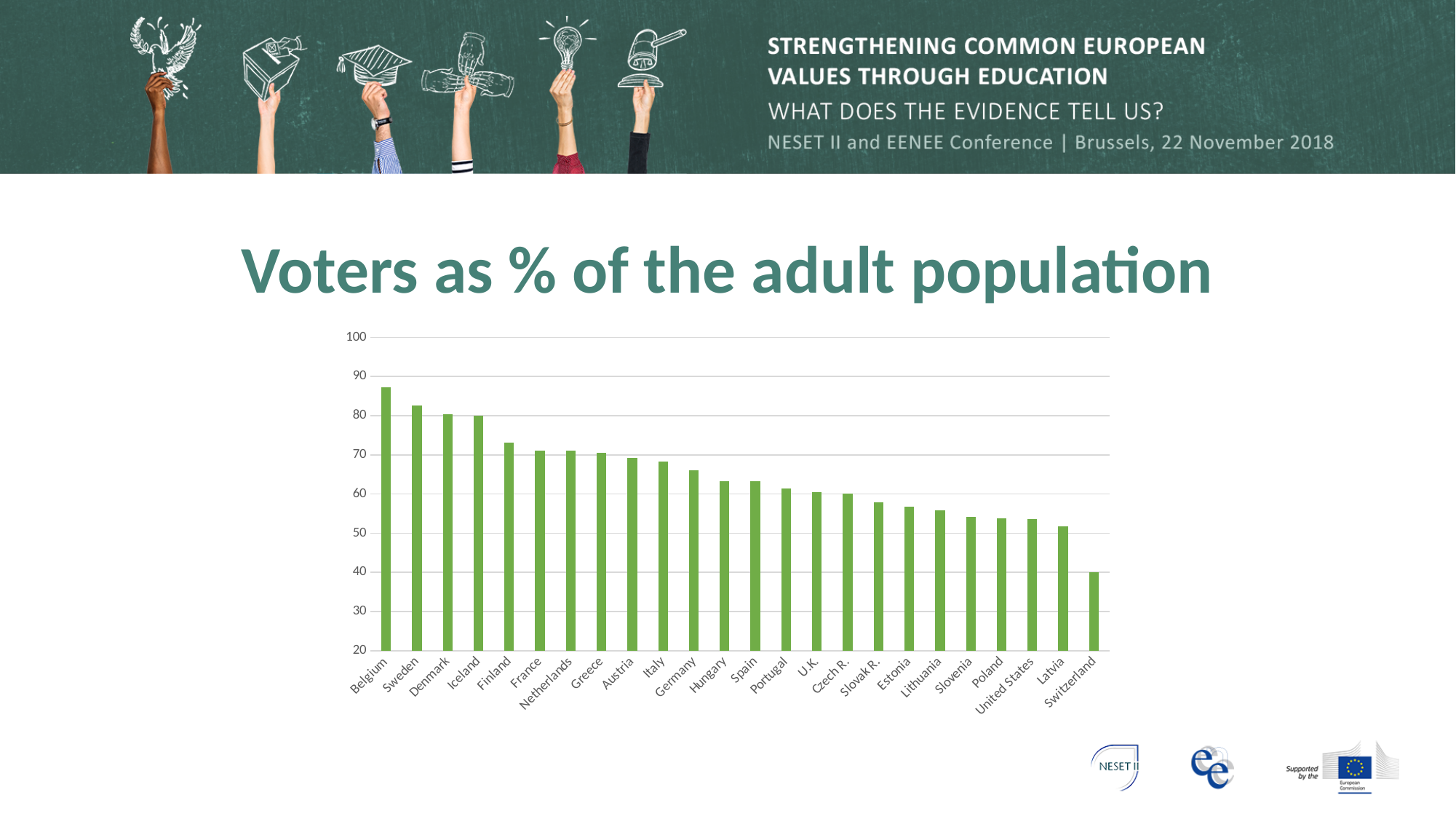
Do the values rise or fall moving from left to right along the x axis? fall How many countries are shown on the x axis of the chart? 24 What kind of chart is shown on the slide? bar chart What is the title of the chart on the slide? Voters as % of the adult population Is the value for Belgium greater or less than 80? greater Is the value for Germany greater or less than 70? less Which country has the highest value in the chart? Belgium Is the value for Switzerland greater or less than 50? less Which country has the lowest value in the chart? Switzerland Which has the larger value, Belgium or Sweden? Belgium Which has the larger value, Latvia or Switzerland? Latvia